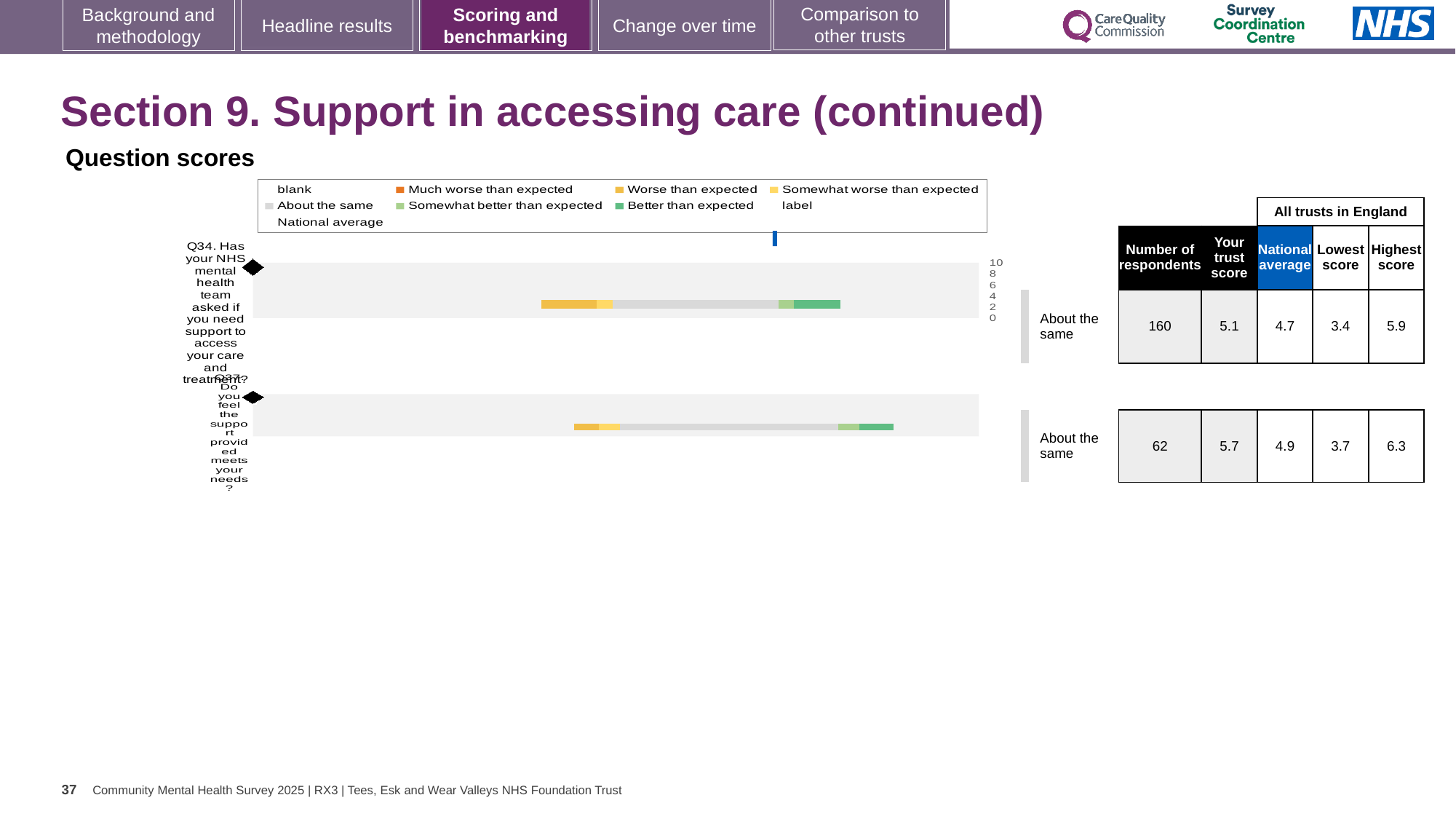
Which question has the higher trust score, Q34 or Q37? Q37 How many questions are plotted in the Question scores chart? 2 What is the number of respondents for Q34? 160 What is the lowest score among all trusts in England for Q34? 3.4 What kind of chart is used to show the question scores? bar chart What benchmark category is shown for Q34? About the same How much higher is the trust score for Q37 than its national average? 0.8 What is the national average for Q37? 4.9 What is the heading above the chart? Question scores Which question has the larger number of respondents? Q34 What is the trust score for Q37? 5.7 What is the difference between the highest score and the lowest score for Q34? 2.5